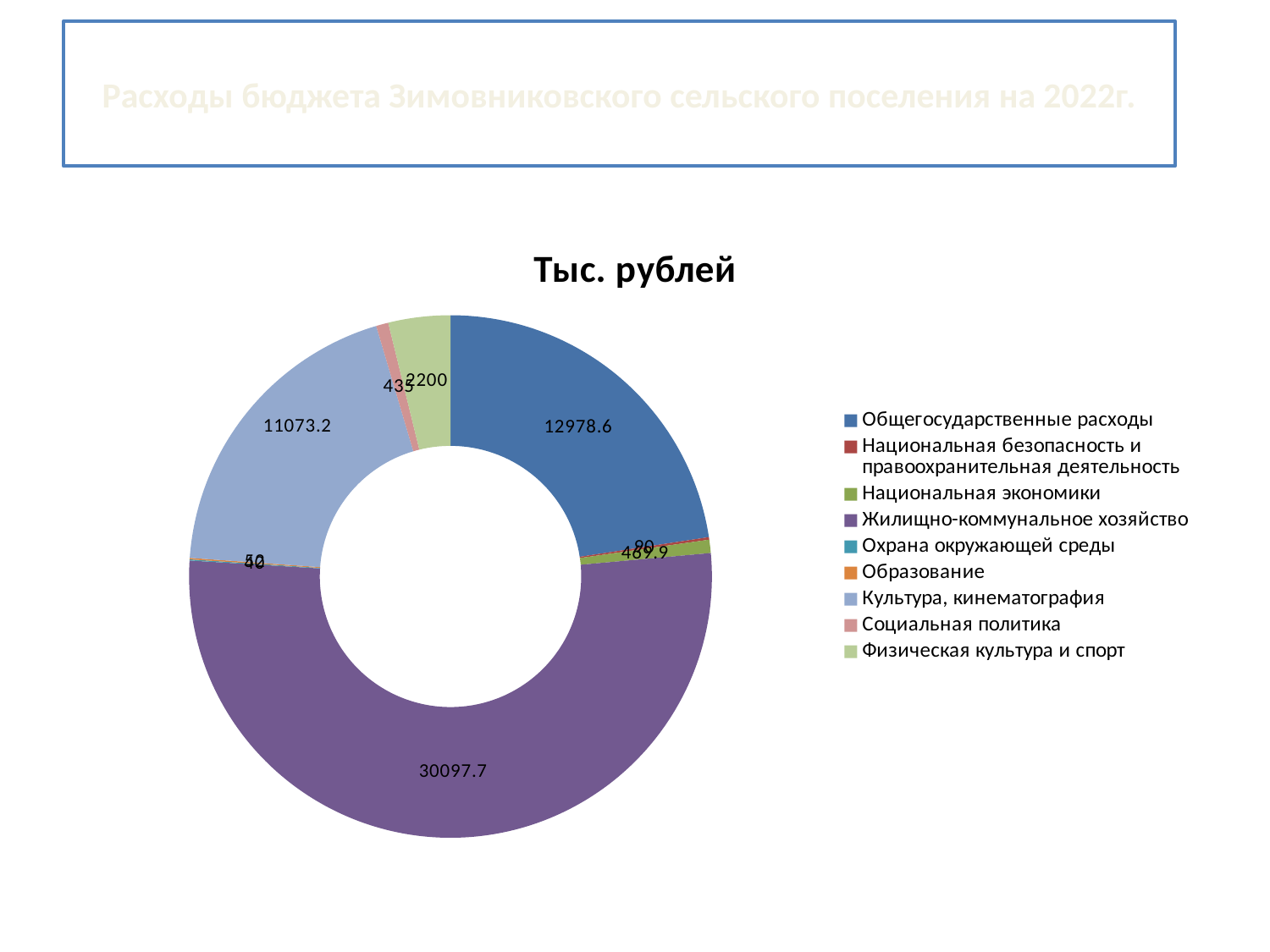
What is the difference between the values for Жилищно-коммунальное хозяйство and Общегосударственные расходы? 17119.1 What is the value for Общегосударственные расходы in the chart? 12978.6 What is the difference between the values for Общегосударственные расходы and Культура, кинематография? 1905.4 How many categories does the legend list? 9 Which is larger: Общегосударственные расходы or Культура, кинематография? Общегосударственные расходы What kind of chart is shown on the slide? Doughnut (pie) chart What is the title of the chart? Тыс. рублей What is the value for Физическая культура и спорт in the chart? 2200 What is the value for Жилищно-коммунальное хозяйство in the chart? 30097.7 What is the value for Культура, кинематография in the chart? 11073.2 Which category has the largest share of the chart? Жилищно-коммунальное хозяйство What colour represents Жилищно-коммунальное хозяйство in the chart? Purple